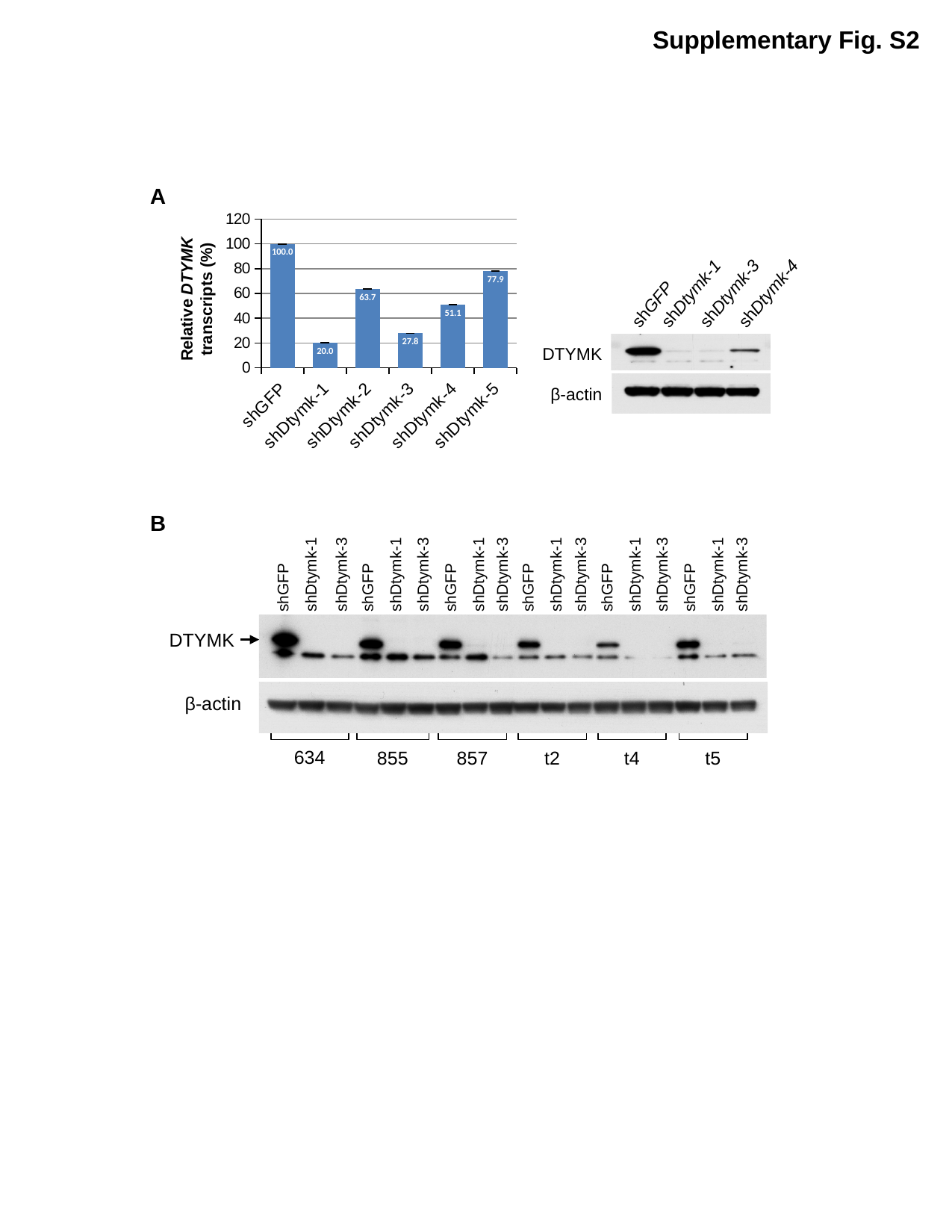
What kind of chart is shown in panel A? bar chart In the bar chart in panel A, what is the difference between the values for shDtymk-2 and shDtymk-4? 12.6 In the bar chart in panel A, what is the relative DTYMK transcript value for shDtymk-3? 27.8 In the bar chart in panel A, what is the relative DTYMK transcript value for shDtymk-1? 20.0 In the bar chart in panel A, which category has the highest relative DTYMK transcript value? shGFP In the bar chart in panel A, which category has the lowest relative DTYMK transcript value? shDtymk-1 In the bar chart in panel A, which has a larger value, shDtymk-2 or shDtymk-5? shDtymk-5 How many categories are shown in the bar chart in panel A? 6 In the bar chart in panel A, what is the relative DTYMK transcript value for shDtymk-5? 77.9 In the bar chart in panel A, what is the difference between the values for shGFP and shDtymk-1? 80.0 What is the y-axis label of the bar chart in panel A? Relative DTYMK transcripts (%) In the bar chart in panel A, is the value for shDtymk-4 greater or less than 40? greater